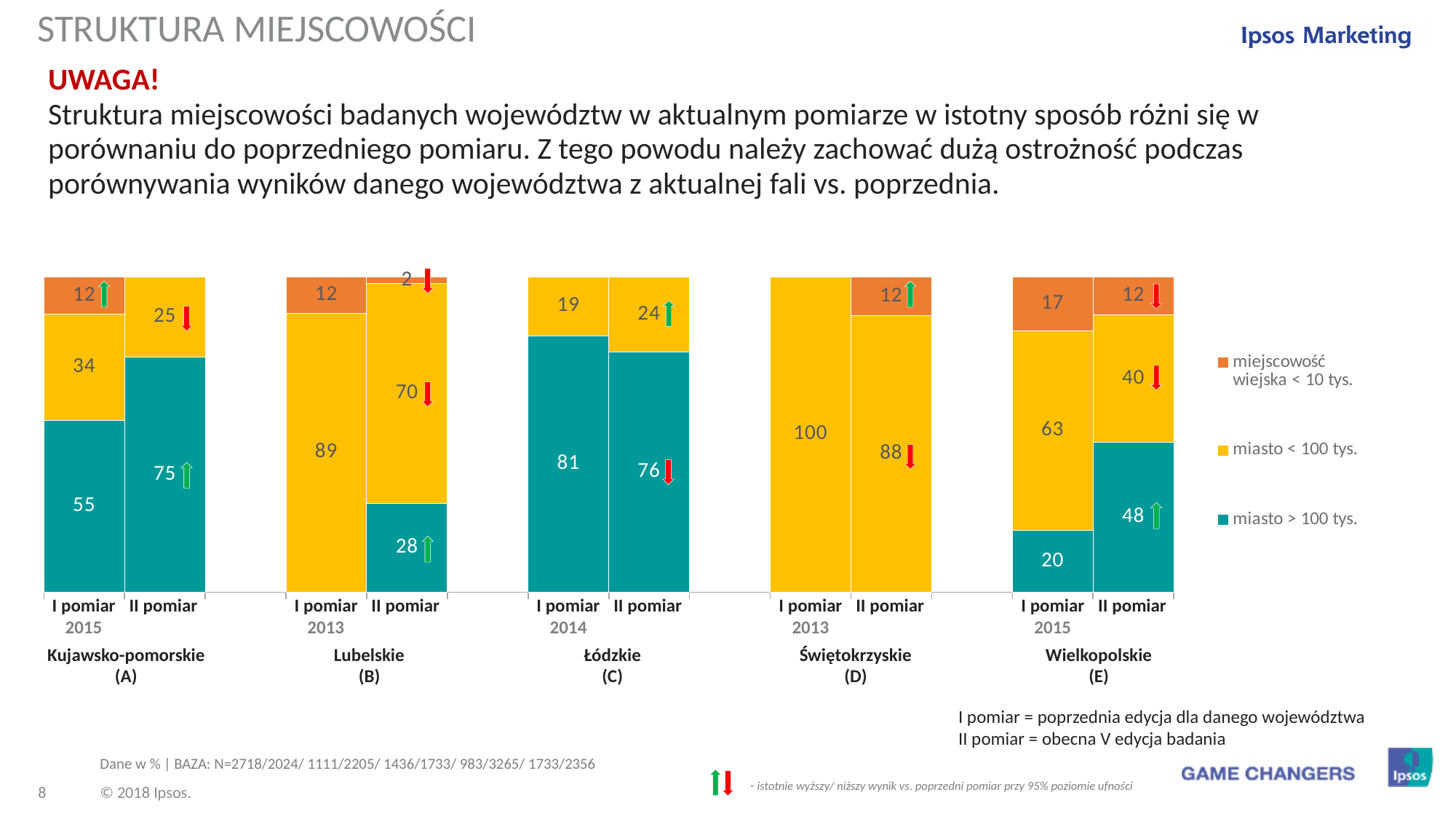
What is the value for 'miasto > 100 tys.' in the II pomiar bar for Wielkopolskie (E)? 48 What is the value for 'miasto > 100 tys.' in the II pomiar bar for Kujawsko-pomorskie (A)? 75 Which is larger for Łódzkie (C): the 'miasto > 100 tys.' value in I pomiar or in II pomiar? I pomiar What is the value for 'miasto < 100 tys.' in the I pomiar bar for Lubelskie (B)? 89 How many regions (voivodeships) are shown on the chart? 5 Which region has the highest 'miasto < 100 tys.' value in I pomiar? Świętokrzyskie (D) What is the total of the II pomiar stacked bar for Wielkopolskie (E)? 100 What is the value for 'miejscowość wiejska < 10 tys.' in the II pomiar bar for Lubelskie (B)? 2 How many series does the legend list? 3 What is the value for 'miasto < 100 tys.' in the I pomiar bar for Świętokrzyskie (D)? 100 What kind of chart is shown on the slide? Stacked bar chart What is the difference between the 'miasto > 100 tys.' values for Wielkopolskie (E) in II pomiar and I pomiar? 28